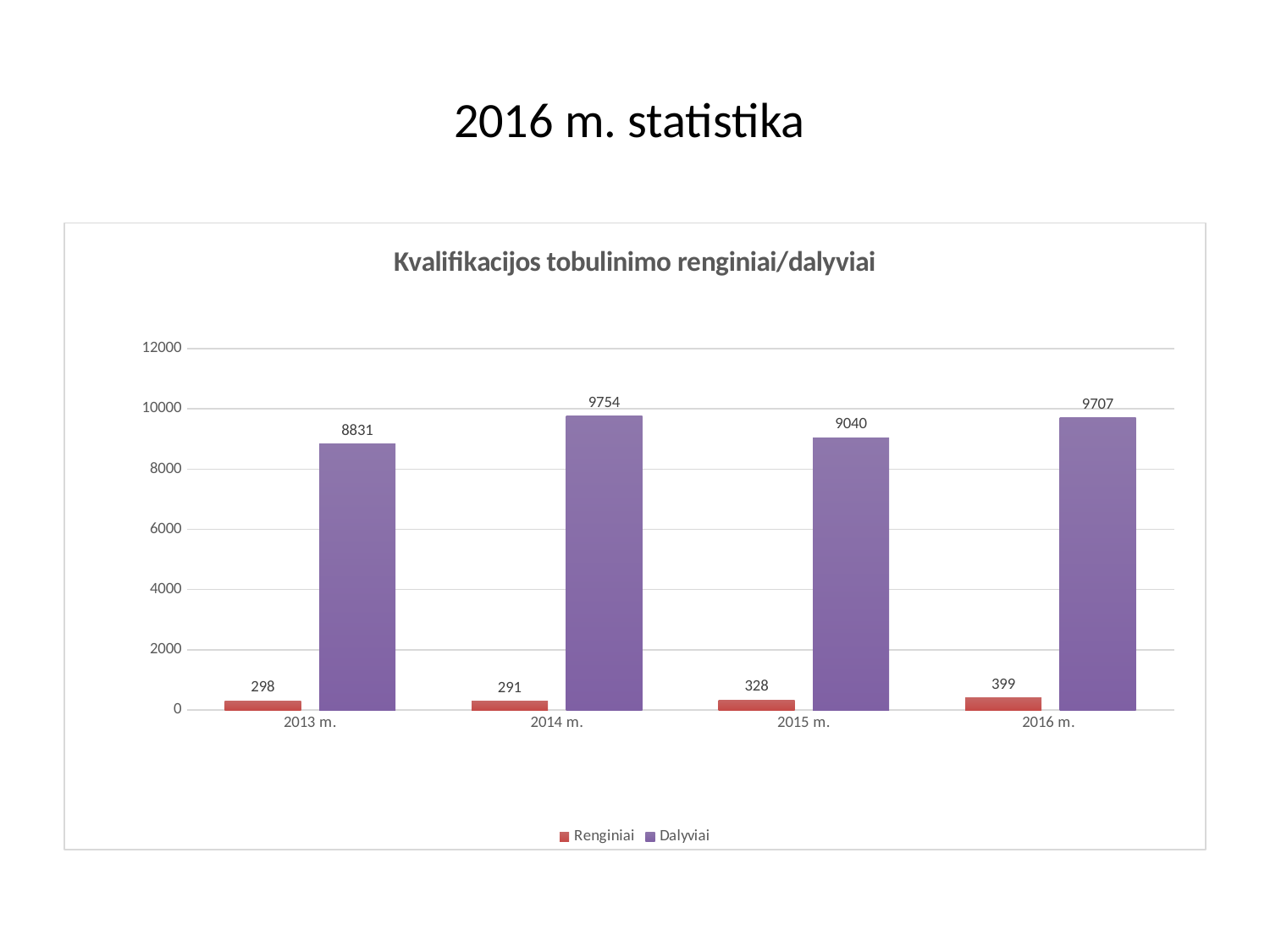
How many years are shown on the x axis? 4 Which year has the lowest Renginiai value? 2014 m. What is the difference between the Dalyviai values for 2014 m. and 2013 m.? 923 Which is larger, the Renginiai value for 2015 m. or for 2013 m.? 2015 m. Is the Dalyviai value for 2015 m. greater or less than 10000? less What is the value of Renginiai for 2016 m.? 399 How many series does the legend list? 2 What is the value of Dalyviai for 2014 m.? 9754 What is the title of the chart? Kvalifikacijos tobulinimo renginiai/dalyviai Which year has the highest Dalyviai value? 2014 m. What is the value of Dalyviai for 2013 m.? 8831 What kind of chart is shown? bar chart